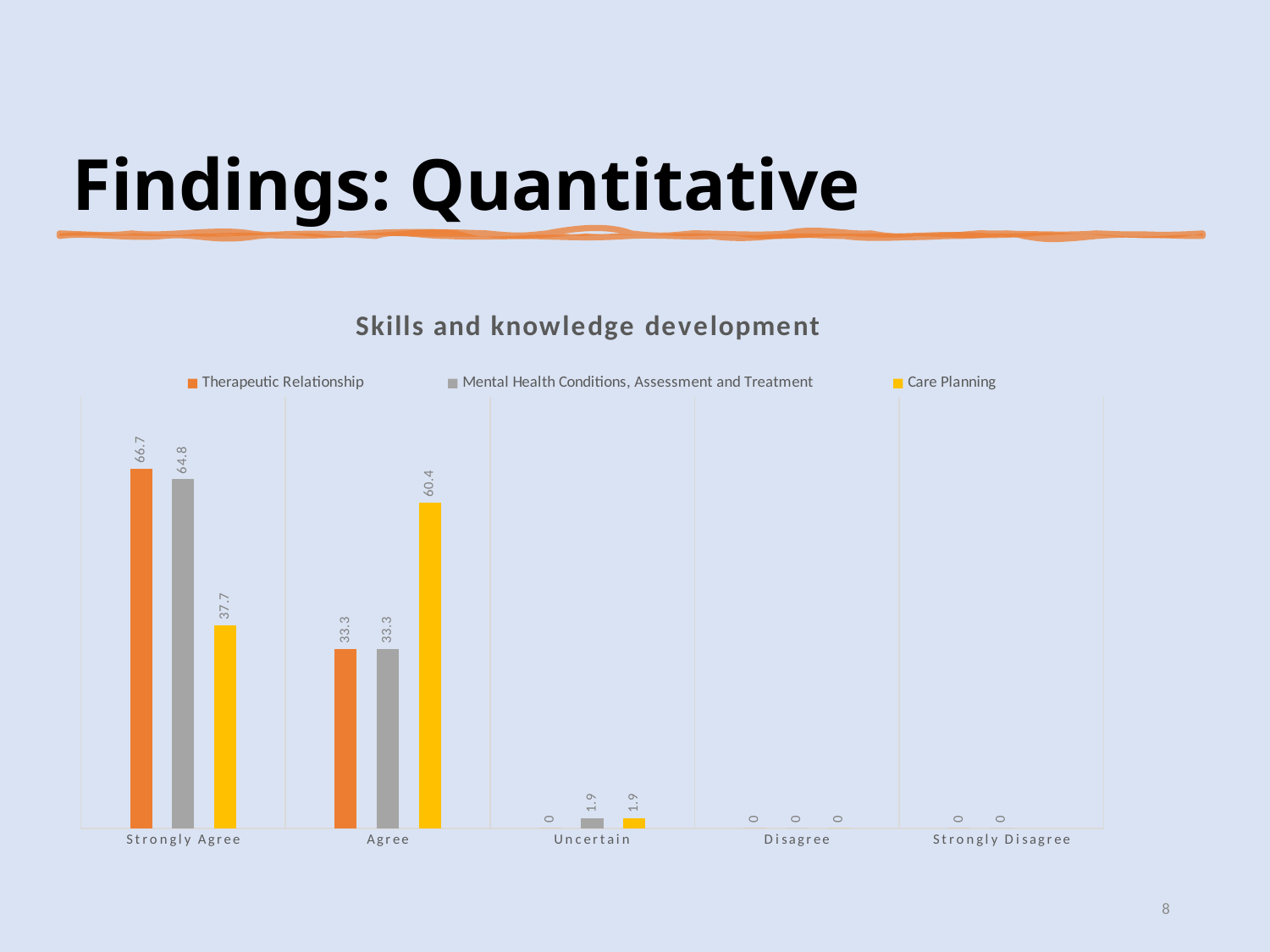
What is the value for Care Planning in the Uncertain category? 1.9 How many series does the legend list? 3 What is the value for Care Planning in the Agree category? 60.4 Which series has the highest value in the Strongly Agree category? Therapeutic Relationship How many categories are shown on the x axis? 5 Which series has the lowest value in the Strongly Agree category? Care Planning What type of chart is shown on the slide? Bar chart What is the difference between the Therapeutic Relationship values for Strongly Agree and Agree? 33.4 What is the value for Therapeutic Relationship in the Strongly Agree category? 66.7 Which is larger: the Care Planning value for Agree or the Care Planning value for Strongly Agree? Agree What is the value for Mental Health Conditions, Assessment and Treatment in the Strongly Agree category? 64.8 What is the difference between the Care Planning values for Agree and Strongly Agree? 22.7